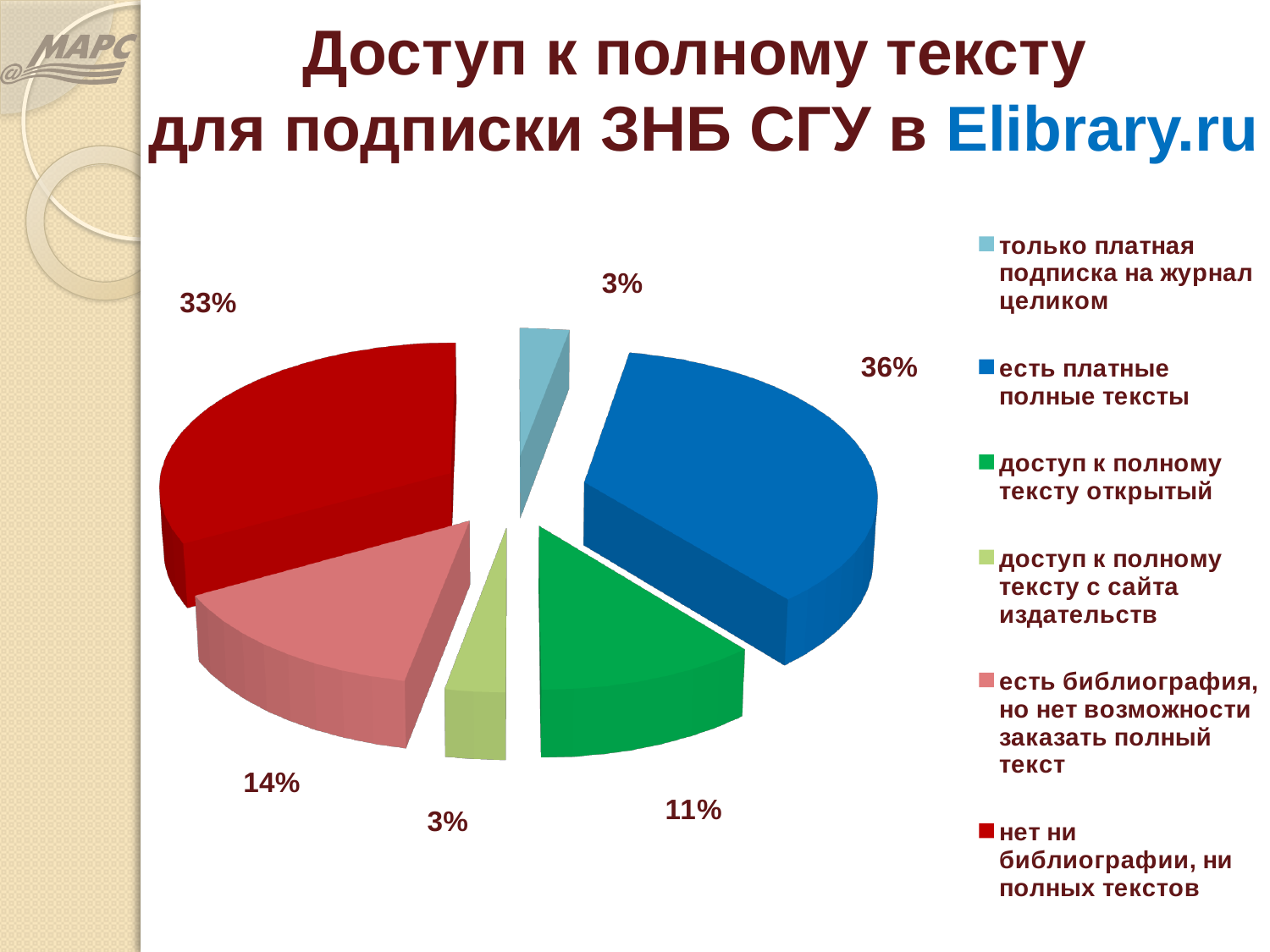
What colour is the slice for "нет ни библиографии, ни полных текстов"? red How many slices does the pie chart have? 6 What percentage is shown for "нет ни библиографии, ни полных текстов"? 33% What kind of chart is shown on the slide? pie chart What is the difference in percentage points between "есть платные полные тексты" and "нет ни библиографии, ни полных текстов"? 3 What share of the pie is labelled "есть платные полные тексты"? 36% Which category has the largest share of the pie? есть платные полные тексты Which is larger: the share for "есть библиография, но нет возможности заказать полный текст" or the share for "доступ к полному тексту открытый"? есть библиография, но нет возможности заказать полный текст What percentage is shown for "есть библиография, но нет возможности заказать полный текст"? 14% What percentage is shown for "доступ к полному тексту открытый"? 11% What is the combined share of "есть платные полные тексты" and "доступ к полному тексту открытый"? 47% What percentage is shown for "только платная подписка на журнал целиком"? 3%